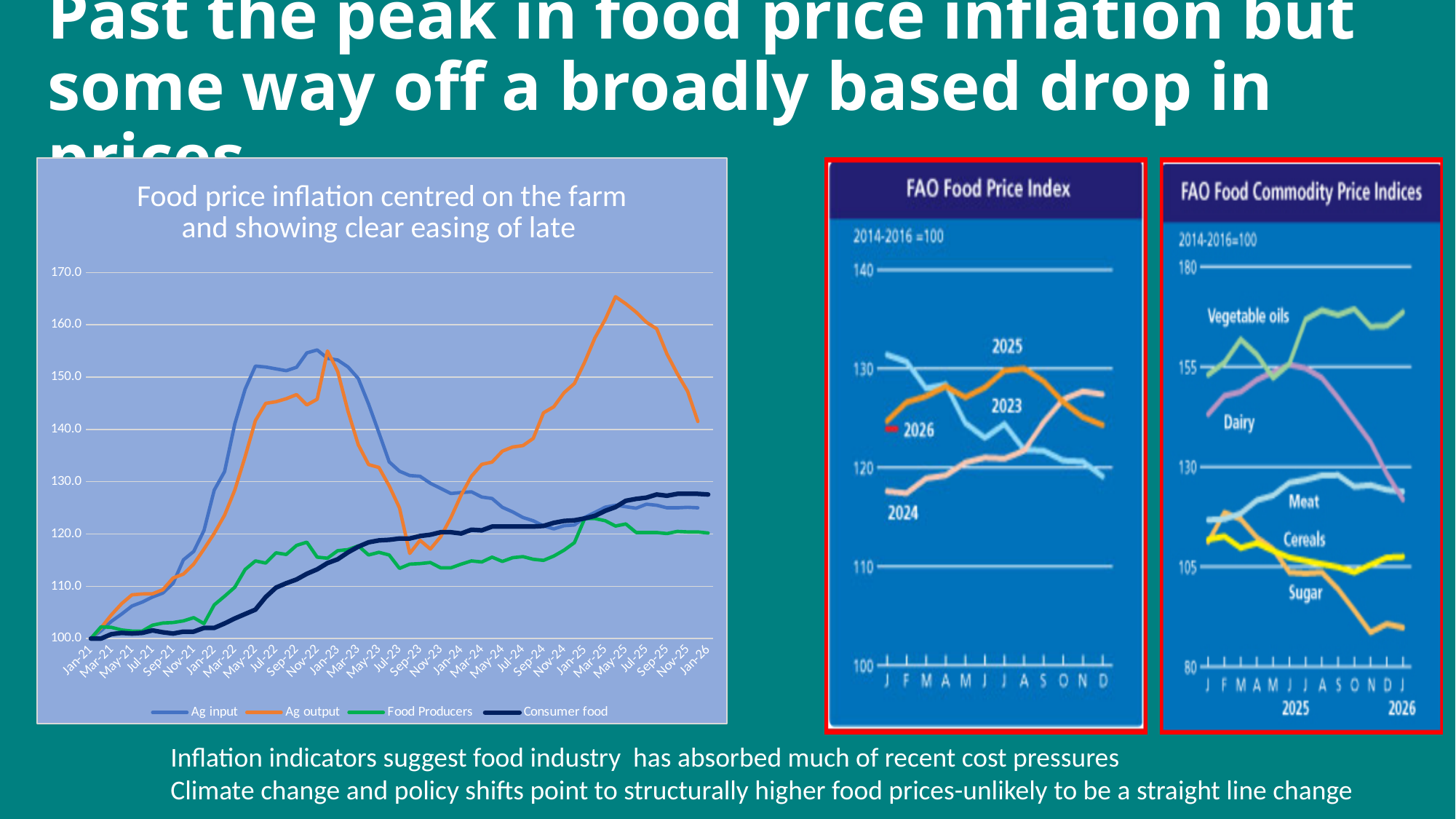
In the left chart, what is the value of Ag input in Jan-21? 100.0 In the FAO Food Price Index chart, which line is higher in December: 2025 or 2023? 2025 In the left chart, which series has the lowest value at Jan-26? Food Producers What kind of chart is the left chart titled 'Food price inflation centred on the farm and showing clear easing of late'? Line chart In the left chart, what colour is the Ag output line? Orange In the left chart, is the value of Consumer food at Jan-26 greater or less than 120.0? greater How many series does the legend of the left chart list? 4 In the left chart, is the peak value of Ag output greater or less than 160.0? greater In the left chart, does the Ag output series rise or fall between May-25 and Jan-26? Fall In the FAO Food Commodity Price Indices chart, which commodity has the highest index at the end of the period? Vegetable oils In the FAO Food Commodity Price Indices chart, is the Sugar index in January 2026 greater or less than 105? less In the left chart, which series reaches the highest peak? Ag output